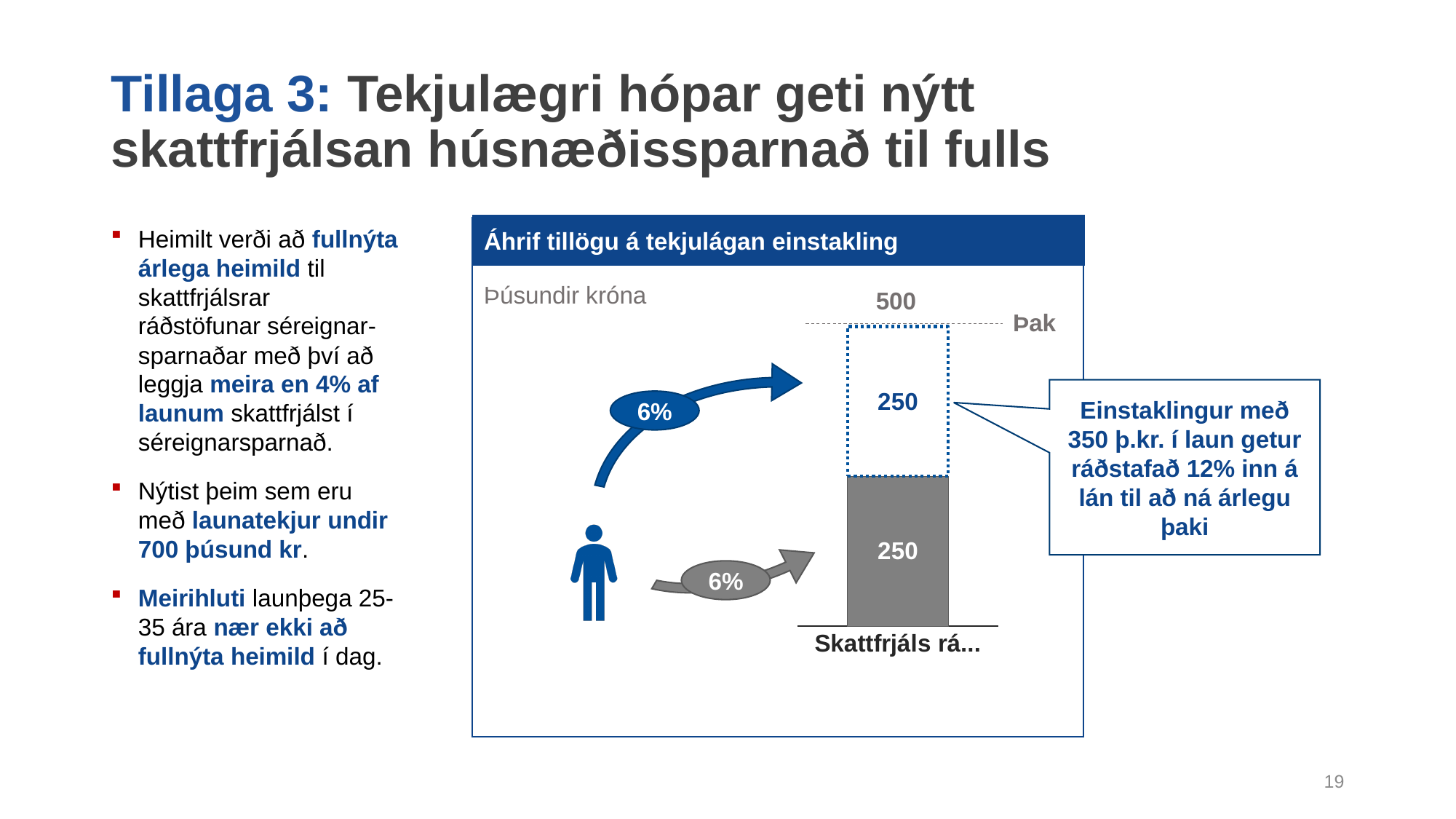
What is the total of the stacked bar (lower segment plus upper segment)? 500 What percentage is shown in the blue oval on the upper arrow? 6% What unit is the chart measured in, according to the label in the top-left of the chart area? Þúsundir króna What value is marked at the top of the bar next to the 'Þak' line? 500 What type of chart is shown on the slide? bar chart How many bars are plotted in the chart? 1 How many segments make up the stacked bar? 2 What percentage is shown in the grey oval on the lower arrow? 6% What is the difference between the upper dotted segment and the lower grey segment of the bar? 0 What is the value of the dotted upper segment of the bar? 250 What is the value of the solid grey lower segment of the bar? 250 What is the title of the chart on the slide? Áhrif tillögu á tekjulágan einstakling